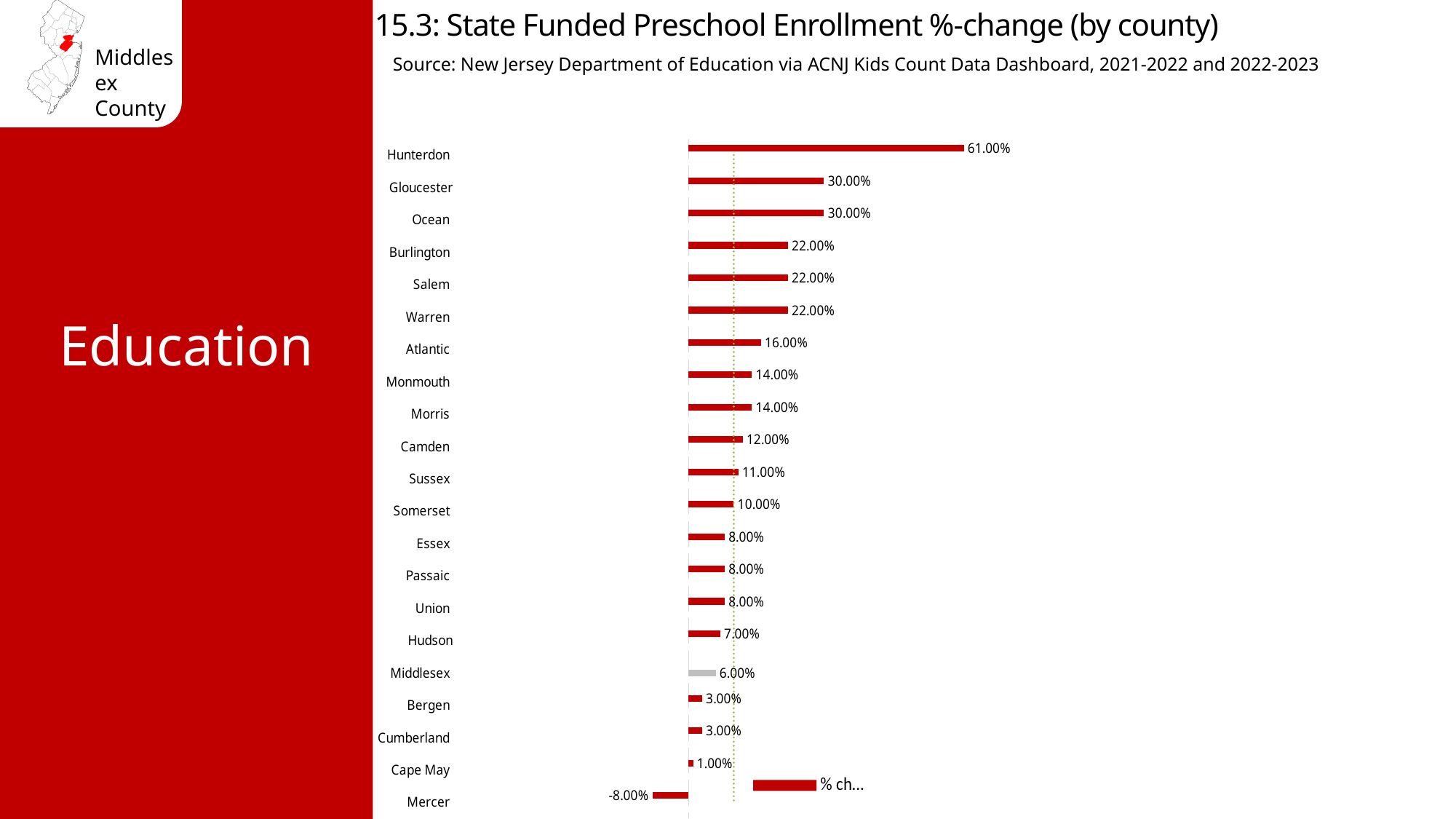
What is the difference between the values for Middlesex and Mercer? 14.00% How many counties are shown in the chart? 21 What is the value shown for Mercer? -8.00% What kind of chart is shown on the slide? Bar chart Which county's bar is coloured grey instead of red? Middlesex What is the value shown for Atlantic? 16.00% Which county has the highest %-change? Hunterdon Which county has the lowest %-change? Mercer What is the value shown for Middlesex? 6.00% Which is larger, the value for Burlington or the value for Camden? Burlington What is the difference between the values for Hunterdon and Gloucester? 31.00% What is the state funded preschool enrollment %-change for Hunterdon? 61.00%